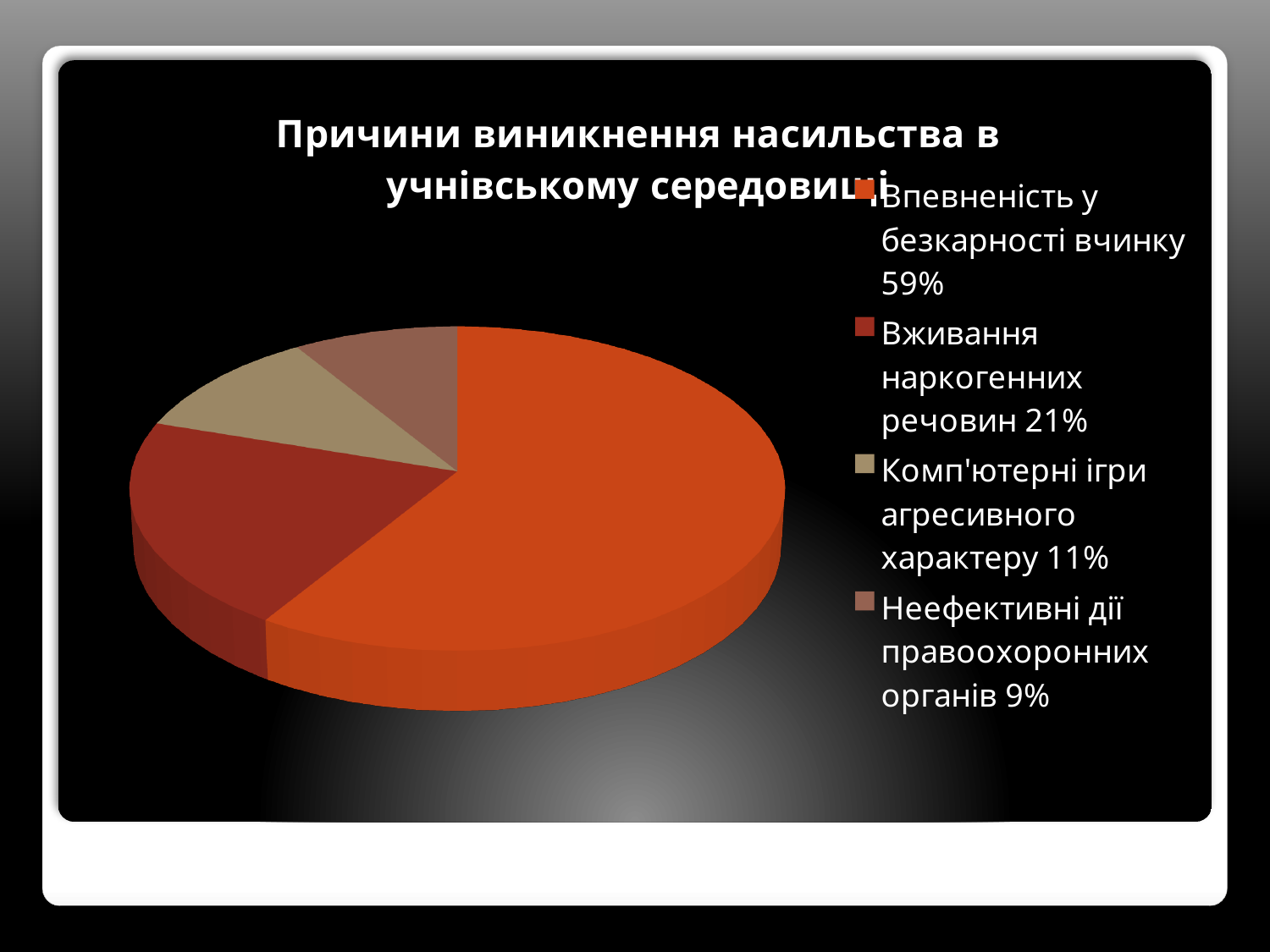
What share of the pie is 'Вживання наркогенних речовин'? 21% What share of the pie is 'Неефективні дії правоохоронних органів'? 9% Which is larger: the share for 'Комп'ютерні ігри агресивного характеру' or for 'Неефективні дії правоохоронних органів'? Комп'ютерні ігри агресивного характеру What kind of chart is shown on the slide? Pie chart What is the difference in percentage points between 'Впевненість у безкарності вчинку' and 'Вживання наркогенних речовин'? 38 What share of the pie is 'Впевненість у безкарності вчинку'? 59% Which category has the largest share of the pie? Впевненість у безкарності вчинку What colour is the slice for 'Впевненість у безкарності вчинку'? Orange Which category has the smallest share of the pie? Неефективні дії правоохоронних органів What is the title of the chart? Причини виникнення насильства в учнівському середовищі How many slices does the pie chart have? 4